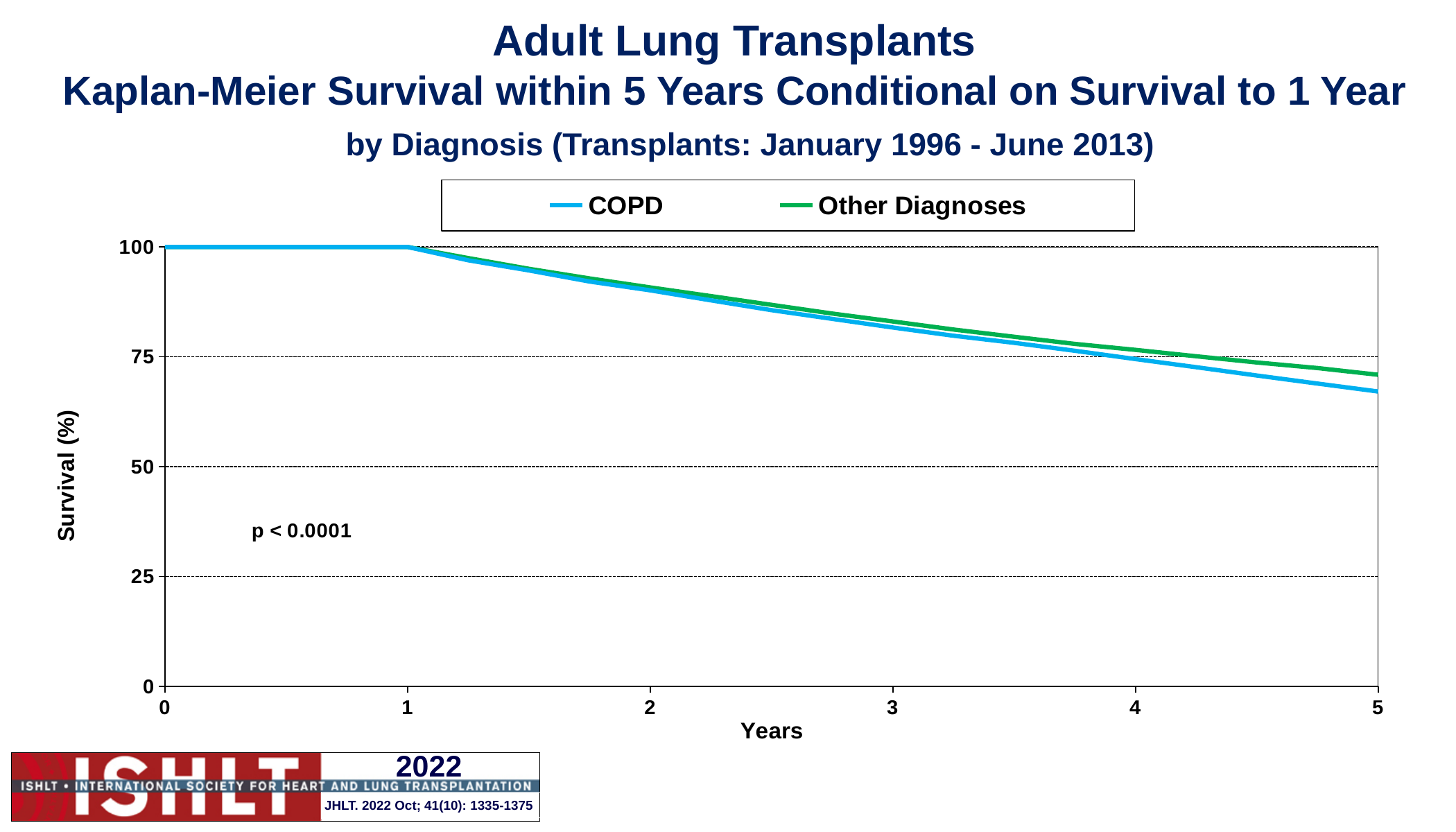
At year 5, which series has the higher survival, COPD or Other Diagnoses? Other Diagnoses Do the survival values rise or fall along the x axis after year 1? fall Is the survival value for COPD at year 3 greater or less than 75? greater Is the survival value for Other Diagnoses at year 5 greater or less than 50? greater Is the survival value for COPD at year 5 greater or less than 75? less What is the survival value for COPD at year 1? 100 What is the survival value for Other Diagnoses at year 1? 100 Which two series are listed in the legend? COPD and Other Diagnoses How many series does the legend list? 2 What p-value is printed on the chart? p < 0.0001 What kind of chart is shown on the slide? line chart